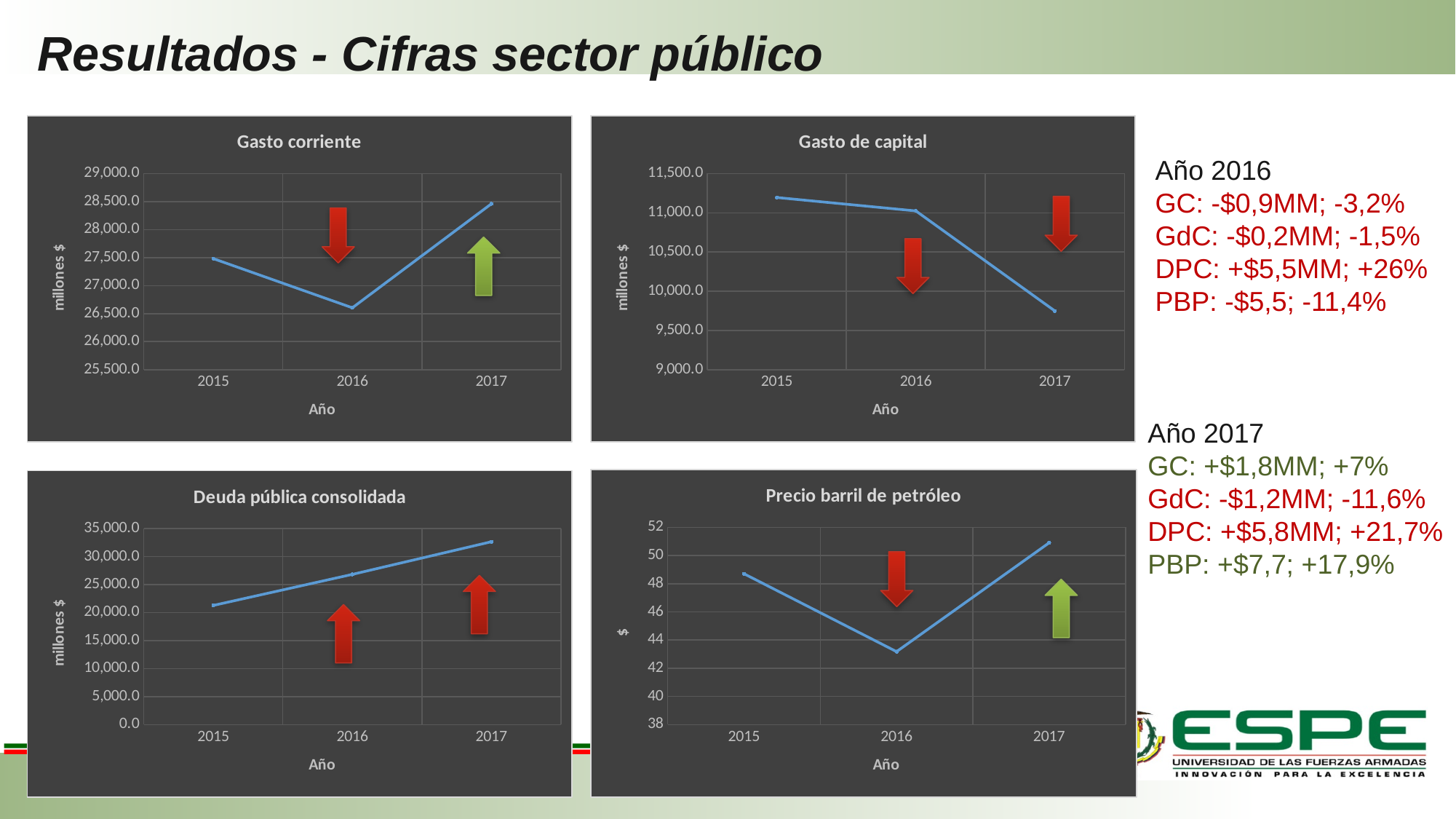
In the 'Gasto de capital' chart, which year has the lowest value? 2017 How many years are plotted on the x axis of the 'Deuda pública consolidada' chart? 3 In the 'Precio barril de petróleo' chart, which year has the lowest value? 2016 What kind of chart is the 'Gasto corriente' chart? line chart In the 'Gasto corriente' chart, which year has the lowest value? 2016 What is the y-axis label of the 'Gasto de capital' chart? millones $ In the 'Precio barril de petróleo' chart, is the value for 2016 greater or less than 44? less In the 'Deuda pública consolidada' chart, do the values rise or fall from 2015 to 2017? rise In the 'Gasto corriente' chart, is the value for 2016 greater or less than 27,000.0? less In the 'Gasto de capital' chart, do the values rise or fall from 2015 to 2017? fall In the 'Deuda pública consolidada' chart, is the value for 2017 greater or less than 30,000.0? greater In the 'Gasto corriente' chart, which year has the highest value? 2017